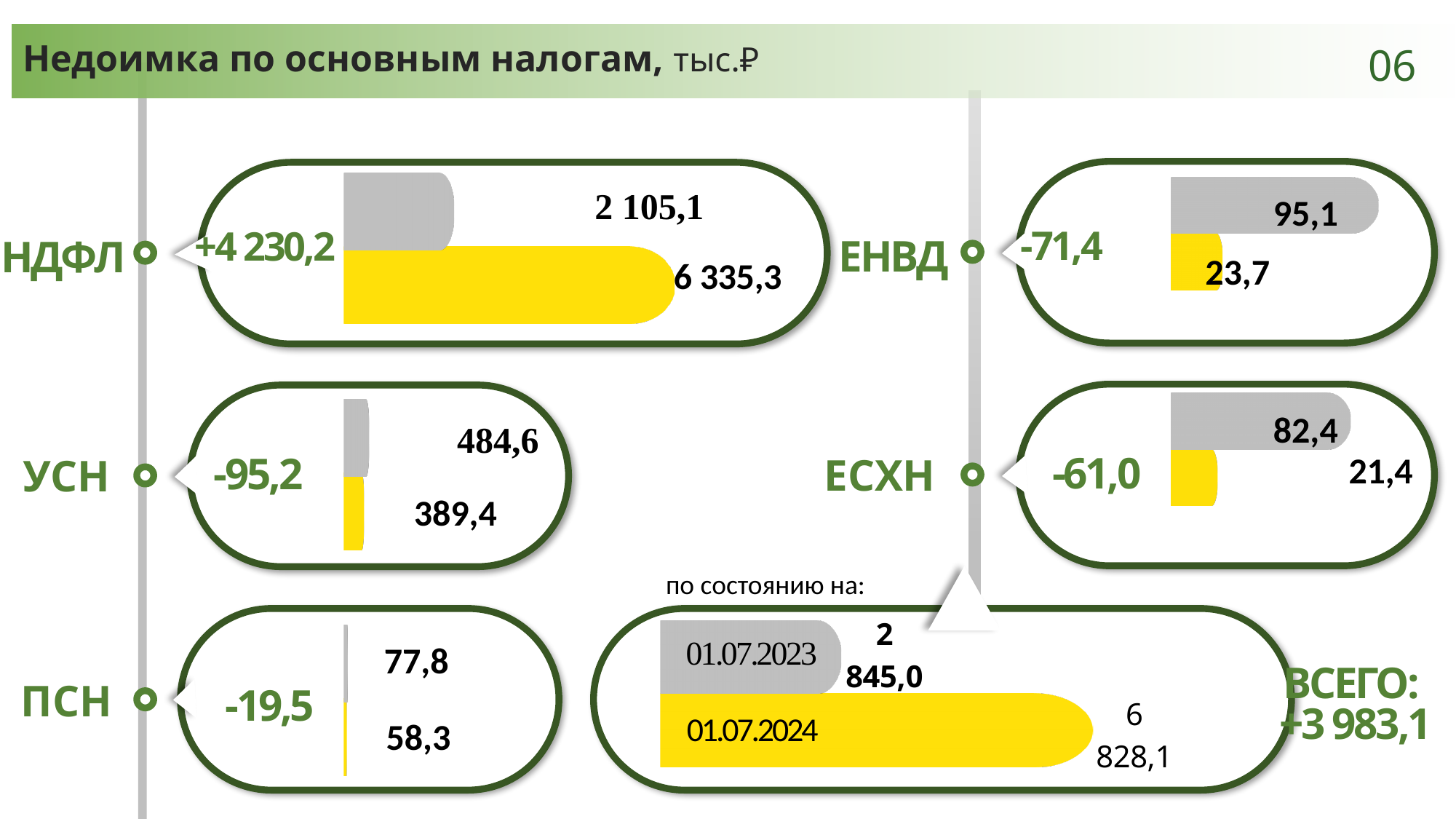
In the ЕНВД chart, which is larger, the value for 01.07.2023 or for 01.07.2024? 01.07.2023 In the НДФЛ chart, what is the value for 01.07.2024? 6 335,3 What is the title of the slide? Недоимка по основным налогам, тыс.₽ In the УСН chart, what is the value for 01.07.2023? 484,6 What kind of chart is used for each tax on the slide? Bar chart In the ПСН chart, what is the value for 01.07.2024? 58,3 In the ВСЕГО (total) chart at the bottom, what is the difference between the 01.07.2024 and 01.07.2023 values? 3 983,1 In the НДФЛ chart, what is the value for 01.07.2023? 2 105,1 In the НДФЛ chart, which is larger, the value for 01.07.2023 or for 01.07.2024? 01.07.2024 In the ЕСХН chart, what is the value for 01.07.2023? 82,4 In the ВСЕГО (total) chart at the bottom, what is the value for 01.07.2024? 6 828,1 In the ЕНВД chart, what is the value for 01.07.2024? 23,7